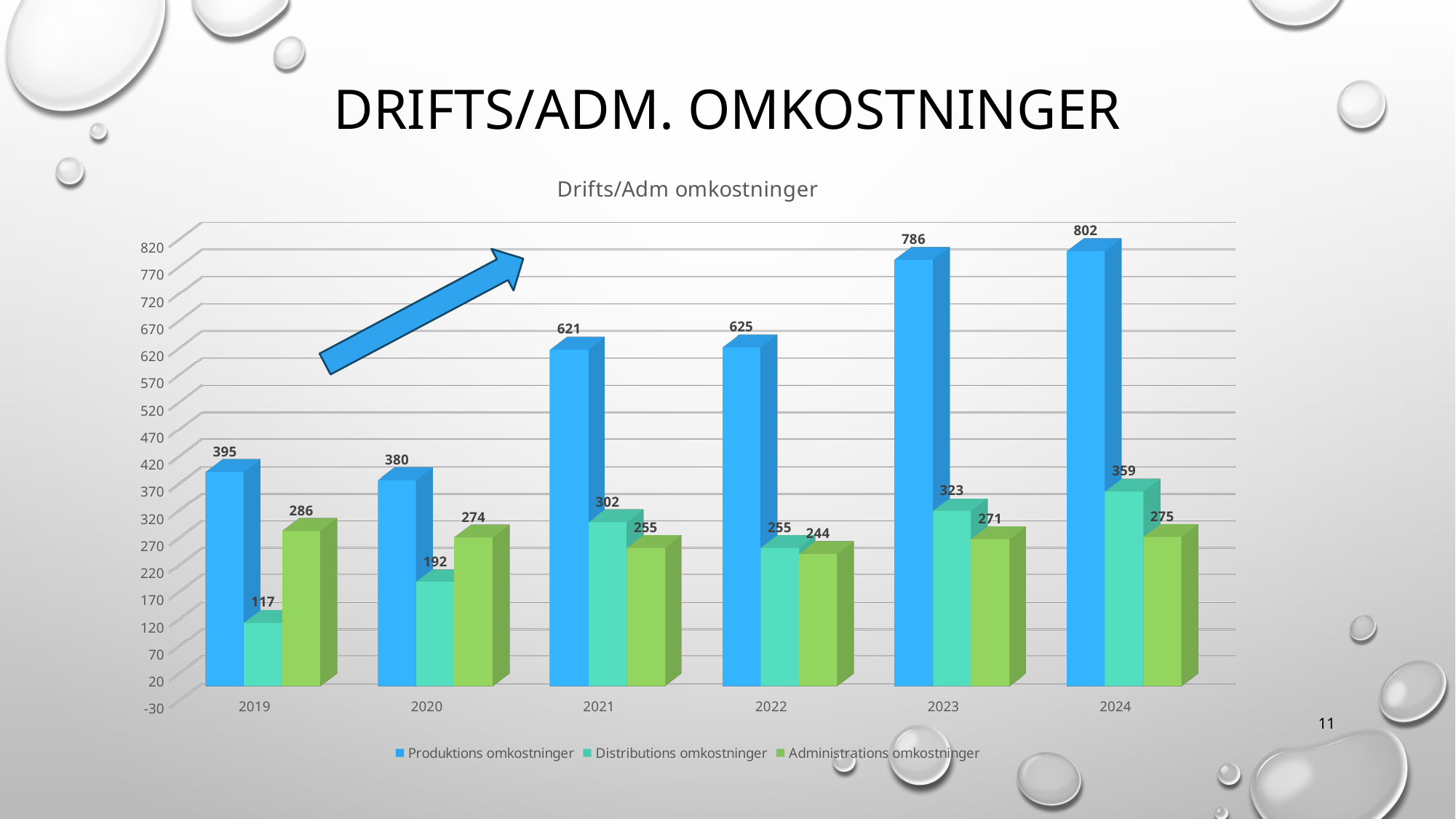
What is the value of Administrations omkostninger in 2022? 244 How many years are shown on the x axis? 6 How many series does the legend list? 3 What is the difference between Produktions omkostninger in 2023 and in 2022? 161 What is the value of Distributions omkostninger in 2020? 192 Which is larger in 2019: Distributions omkostninger or Administrations omkostninger? Administrations omkostninger Does Produktions omkostninger generally rise or fall from 2019 to 2024? Rise What is the title of the chart? Drifts/Adm omkostninger What is the value of Produktions omkostninger in 2024? 802 In which year is Distributions omkostninger lowest? 2019 In which year is Produktions omkostninger highest? 2024 What kind of chart is shown on the slide? Bar chart